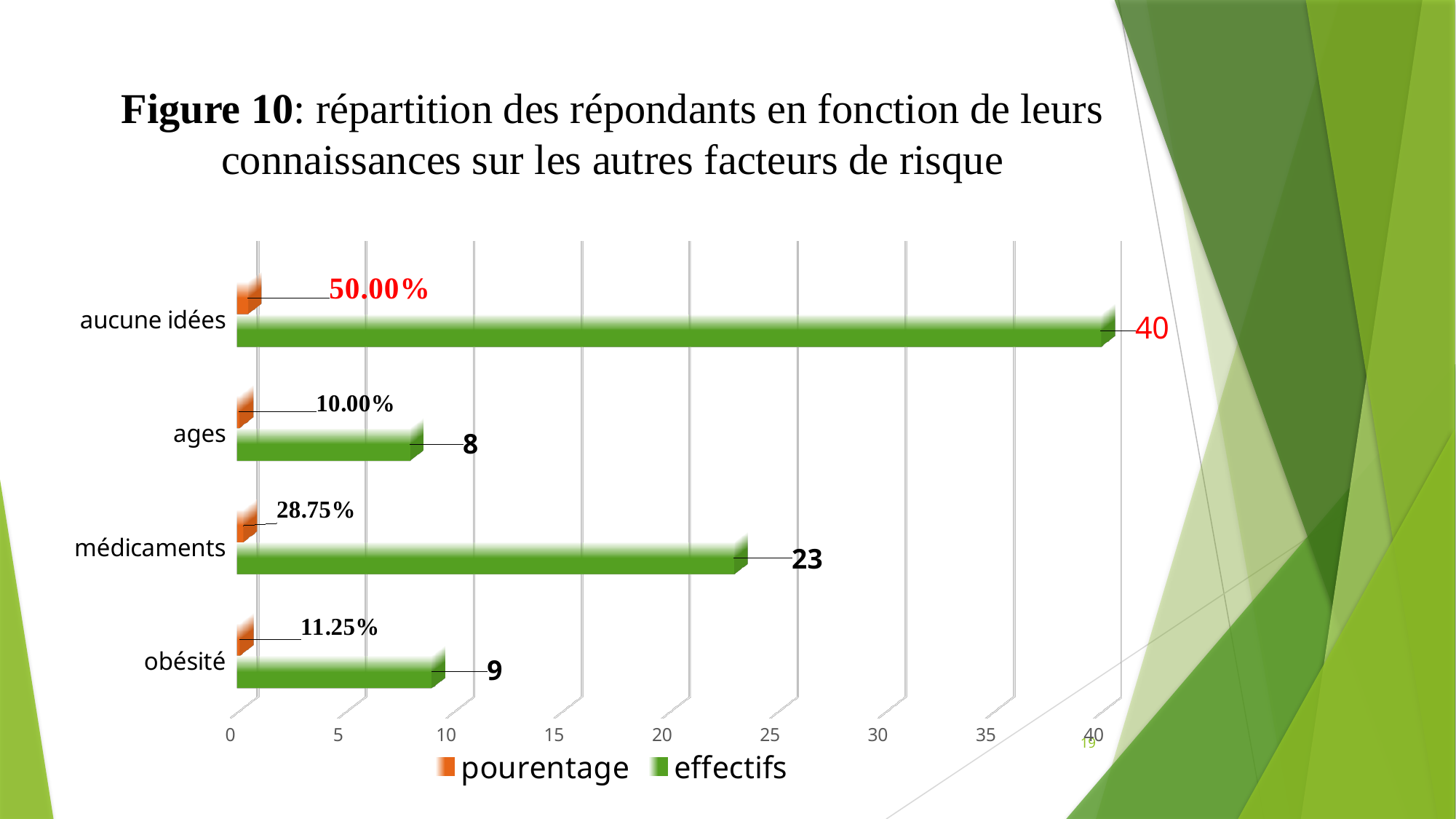
What kind of chart is shown on the slide? bar chart What is the pourentage value for ages? 10.00% What colour are the effectifs bars? green Which has a larger effectifs value, médicaments or obésité? médicaments Which category has the highest effectifs value? aucune idées What is the effectifs value for obésité? 9 What is the difference between the effectifs values for aucune idées and médicaments? 17 What is the pourentage value for médicaments? 28.75% What is the effectifs value for aucune idées? 40 How many series does the legend list? 2 How many categories are shown on the chart? 4 Which category has the lowest effectifs value? ages